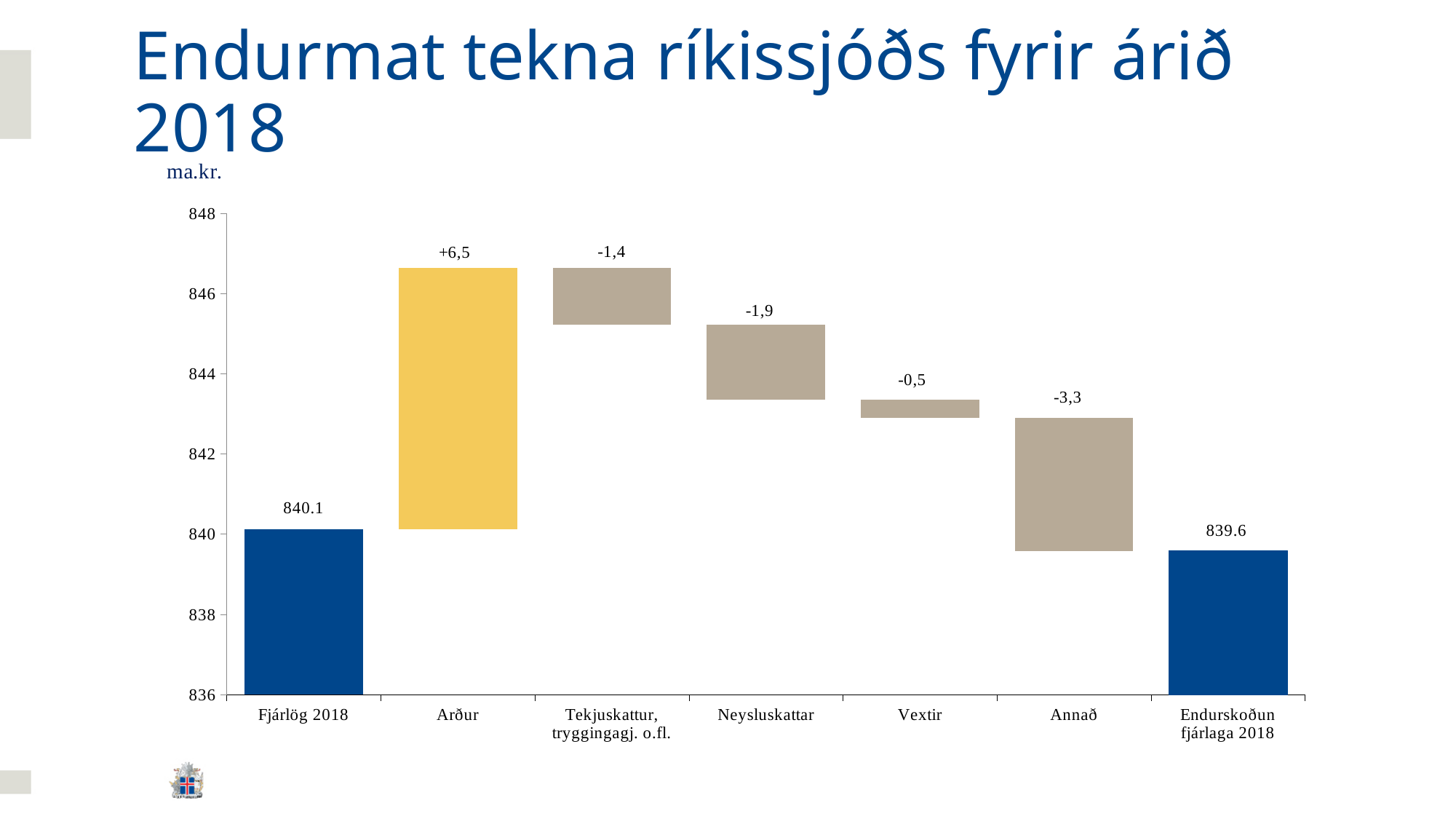
What is the value shown for Endurskoðun fjárlaga 2018? 839.6 What change is labelled for Arður? +6,5 How many categories are shown on the x axis? 7 Which is larger, the value for Fjárlög 2018 or the value for Endurskoðun fjárlaga 2018? Fjárlög 2018 What change is labelled for Vextir? -0,5 What change is labelled for Neysluskattar? -1,9 What is the value shown for Fjárlög 2018? 840.1 What is the difference between the Fjárlög 2018 value and the Endurskoðun fjárlaga 2018 value? 0.5 Which category shows the largest negative change? Annað What change is labelled for Annað? -3,3 Which category shows the smallest change in absolute terms? Vextir What unit is shown above the vertical axis? ma.kr.